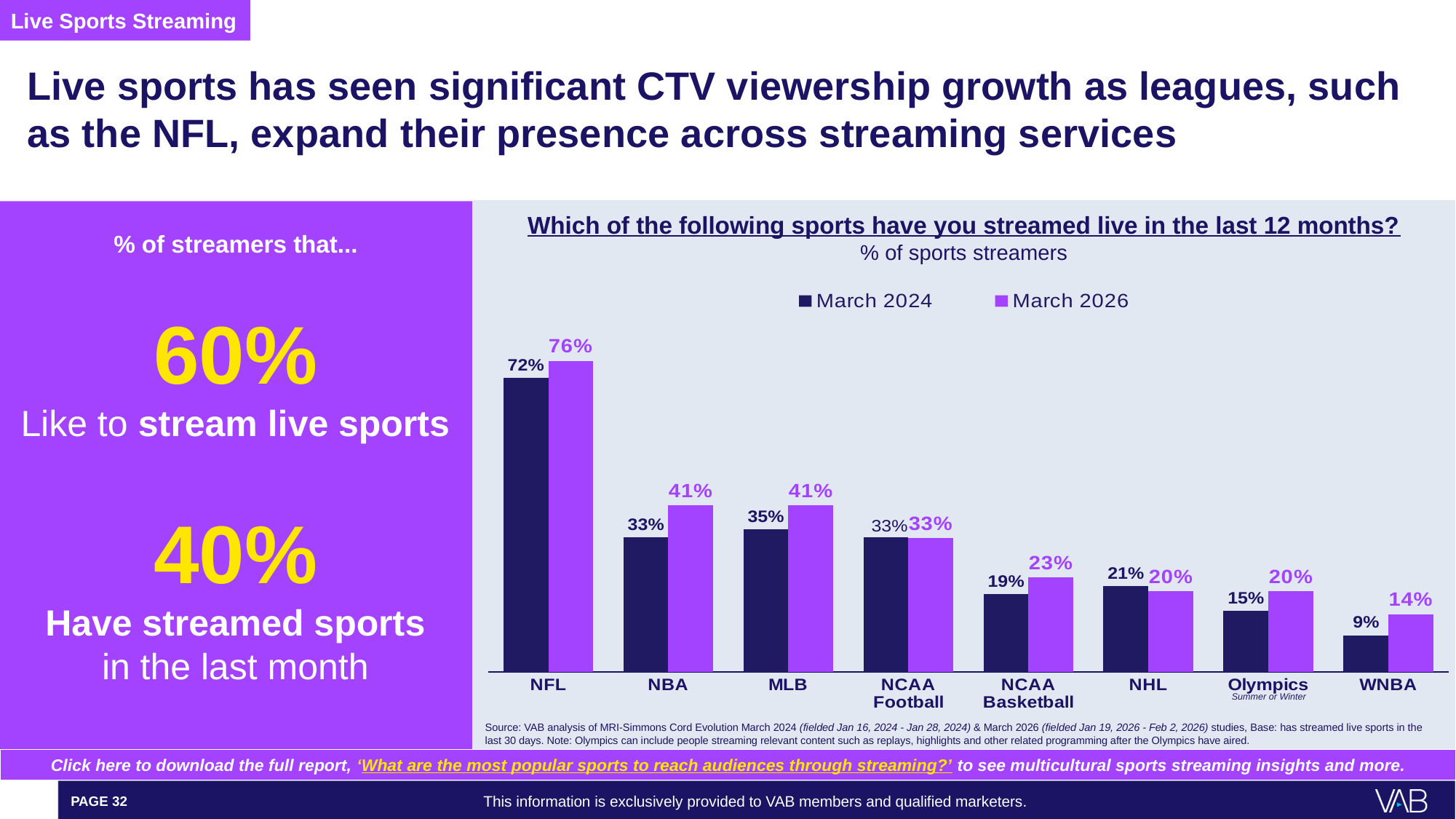
How many sports categories are shown on the chart? 8 What was the March 2024 value for WNBA? 9% What percentage of sports streamers streamed the NFL live in March 2026? 76% Which sport has the lowest March 2024 value? WNBA What is the difference between the March 2024 and March 2026 values for the NHL? 1 percentage point Which is larger for NCAA Basketball: the March 2024 value or the March 2026 value? March 2026 How many series does the legend list? 2 Which sport has the highest March 2026 value? NFL What kind of chart is shown on the slide? Bar chart Which colour represents March 2026 in the chart? Purple What was the March 2024 value for MLB? 35% What is the difference between the March 2026 and March 2024 values for the NBA? 8 percentage points